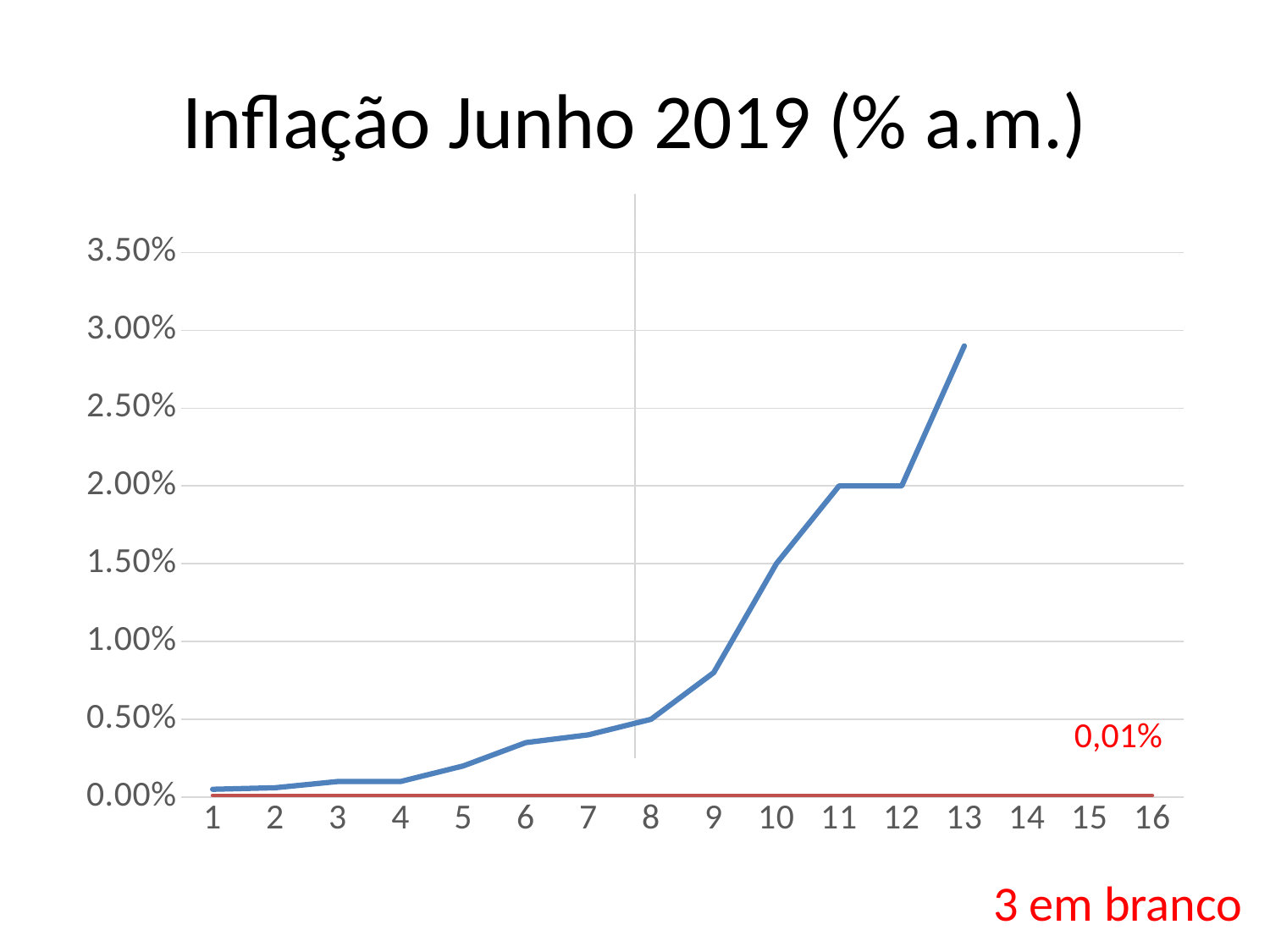
What kind of chart is shown on the slide? line chart Is the value of the blue line at point 10 greater or less than 1.00%? greater Is the value of the blue line at point 4 greater or less than 0.50%? less Do the values of the blue line rise or fall from point 1 to point 13? rise What is the highest value shown on the y axis? 3.50% Is the value of the blue line at point 13 greater or less than 2.50%? greater Which has the larger value on the blue line, point 9 or point 11? point 11 What is the title of the chart? Inflação Junho 2019 (% a.m.) How many numbered points are shown on the x axis? 16 What value is printed in red next to the flat red line? 0,01% At which x-axis point does the blue line reach its highest value? 13